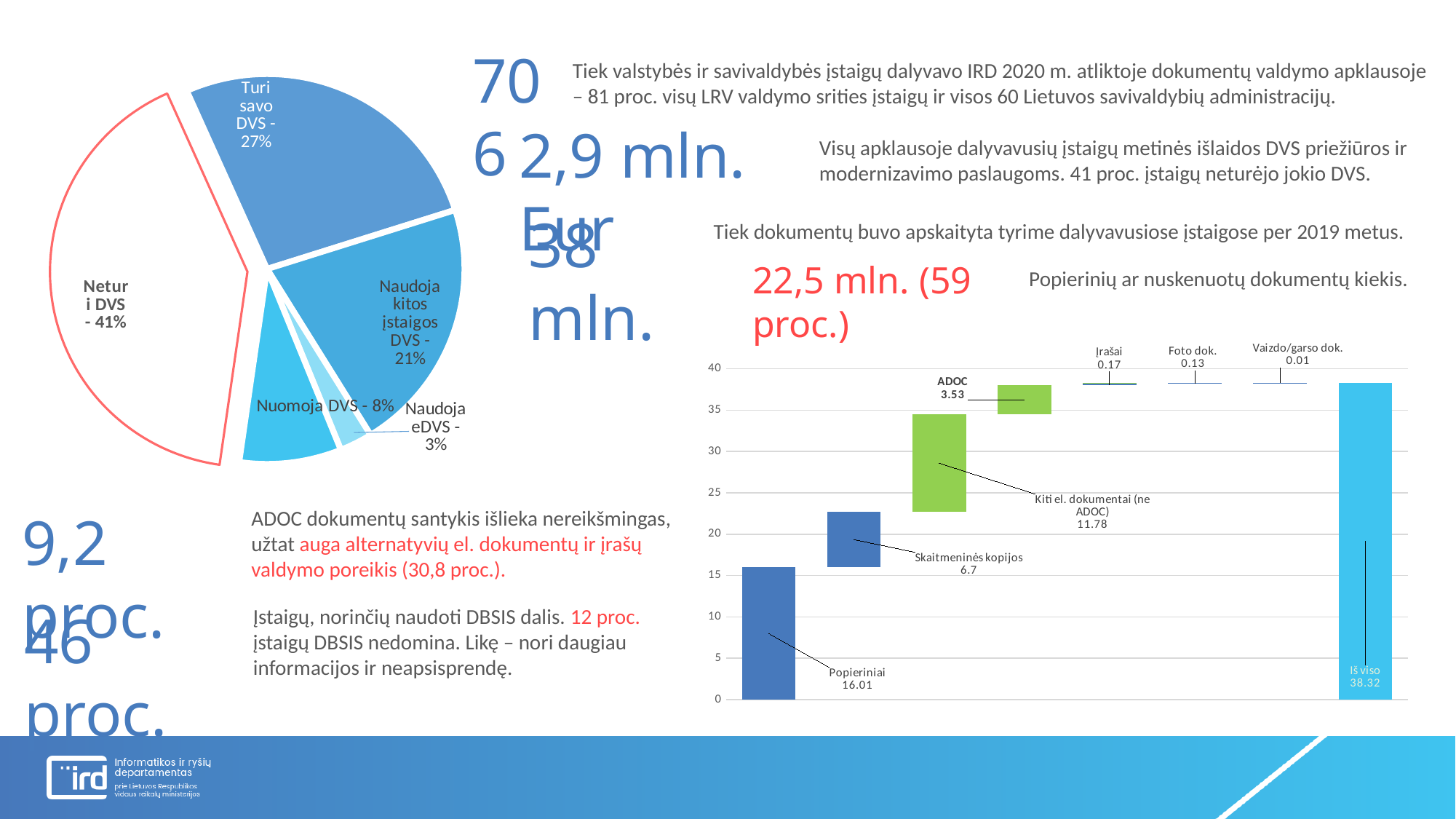
In the bar chart on the right, what is the value labelled for 'Iš viso'? 38.32 In the pie chart on the left, which category has the largest share? Neturi DVS What type of chart is shown on the right side of the slide? Bar chart In the bar chart on the right, what is the value for 'Popieriniai'? 16.01 In the bar chart on the right, what is the difference between 'Popieriniai' and 'Skaitmeninės kopijos'? 9.31 In the bar chart on the right, which is larger: 'Skaitmeninės kopijos' or 'ADOC'? Skaitmeninės kopijos In the pie chart on the left, what is the difference in percentage points between 'Turi savo DVS' and 'Nuomoja DVS'? 19 In the pie chart on the left, what share is labelled for 'Naudoja kitos įstaigos DVS'? 21% In the pie chart on the left, how many slices are there? 5 In the pie chart on the left, what share is labelled for 'Neturi DVS'? 41% In the pie chart on the left, which category has the smallest share? Naudoja eDVS In the bar chart on the right, what is the value for 'Kiti el. dokumentai (ne ADOC)'? 11.78